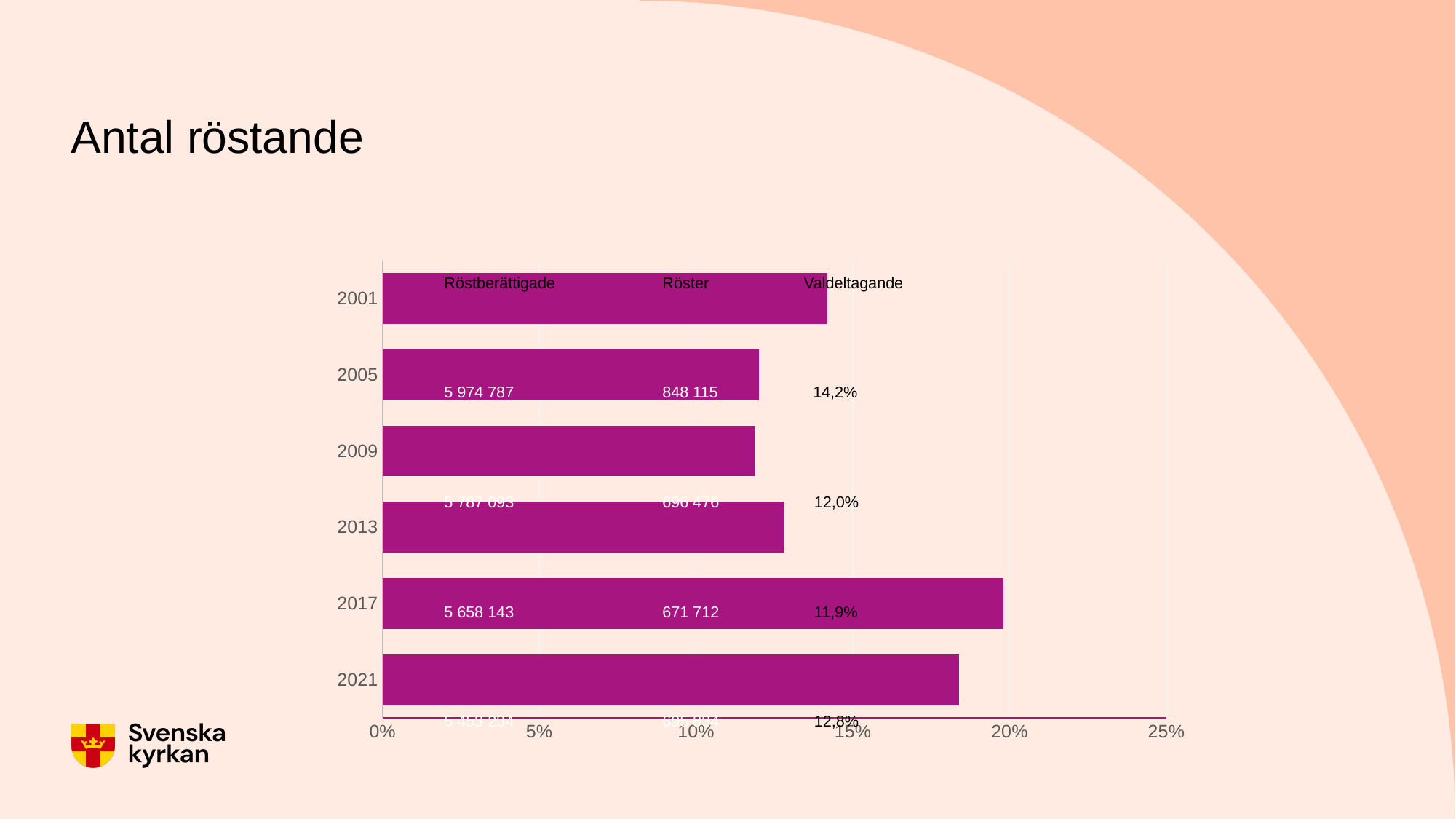
What kind of chart is shown on the slide? bar chart Is the bar for 2017 greater or less than 15%? greater Which bar is longer, 2001 or 2013? 2001 Is the bar for 2001 greater or less than 15%? less Which year has the longest bar on the chart? 2017 What is the highest value shown on the x axis of the chart? 25% Is the bar for 2013 greater or less than 15%? less Which bar is longer, 2017 or 2021? 2017 How many years are shown as categories on the chart? 6 What is the title of the slide containing the chart? Antal röstande